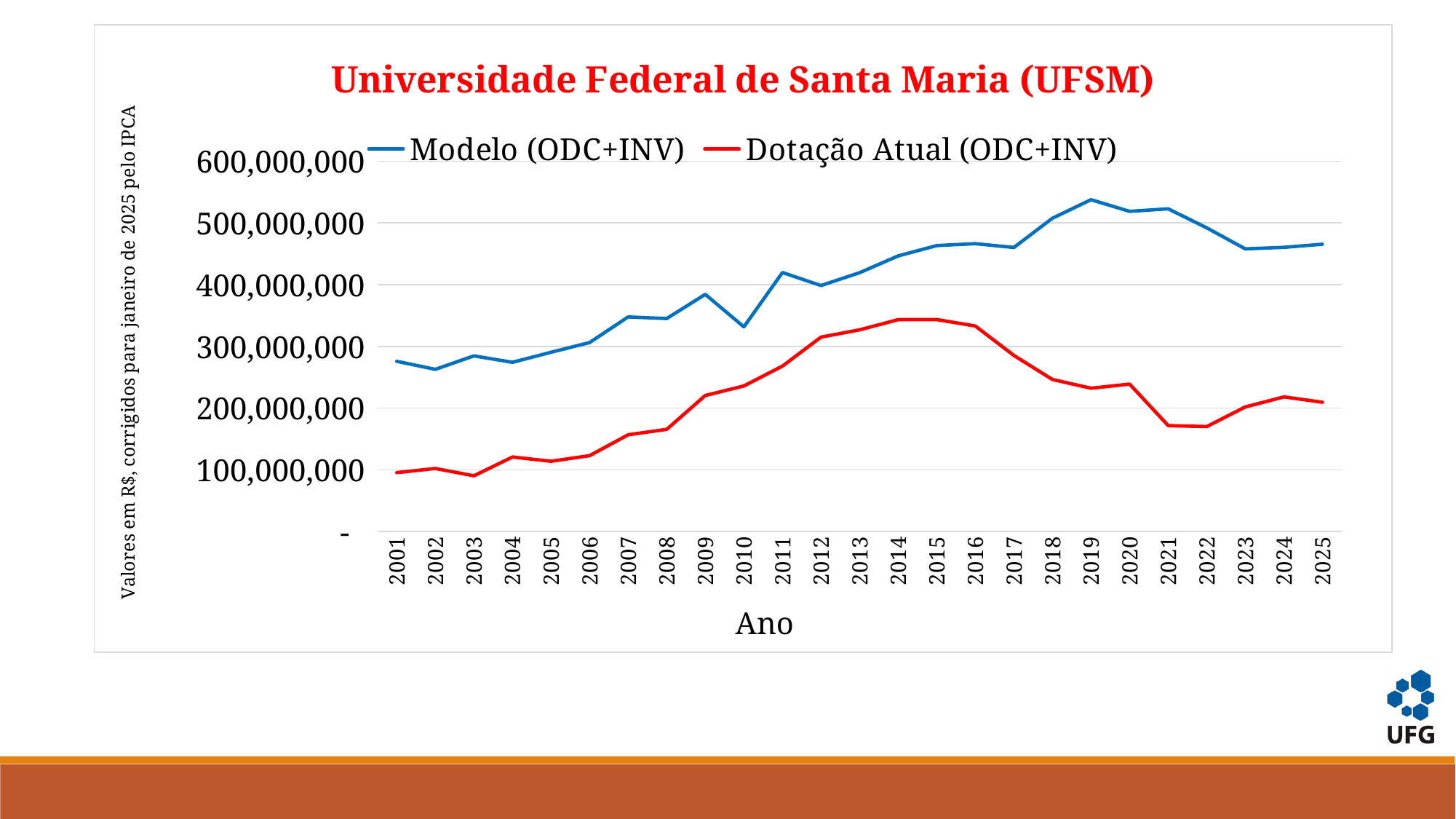
How many years are plotted along the x axis? 25 What kind of chart is shown on the slide? line chart Is the value for Dotação Atual (ODC+INV) in 2021 greater or less than 200,000,000? less In 2025, which series has the larger value, Modelo (ODC+INV) or Dotação Atual (ODC+INV)? Modelo (ODC+INV) How many series does the legend list? 2 Is the value for Modelo (ODC+INV) in 2001 greater or less than 300,000,000? less What is the title of the chart? Universidade Federal de Santa Maria (UFSM) Is the value for Dotação Atual (ODC+INV) in 2012 greater or less than 300,000,000? greater In which year is the Modelo (ODC+INV) series at its lowest value? 2002 Does the Dotação Atual (ODC+INV) series rise or fall between 2016 and 2022? fall In which year does the Modelo (ODC+INV) series reach its highest value? 2019